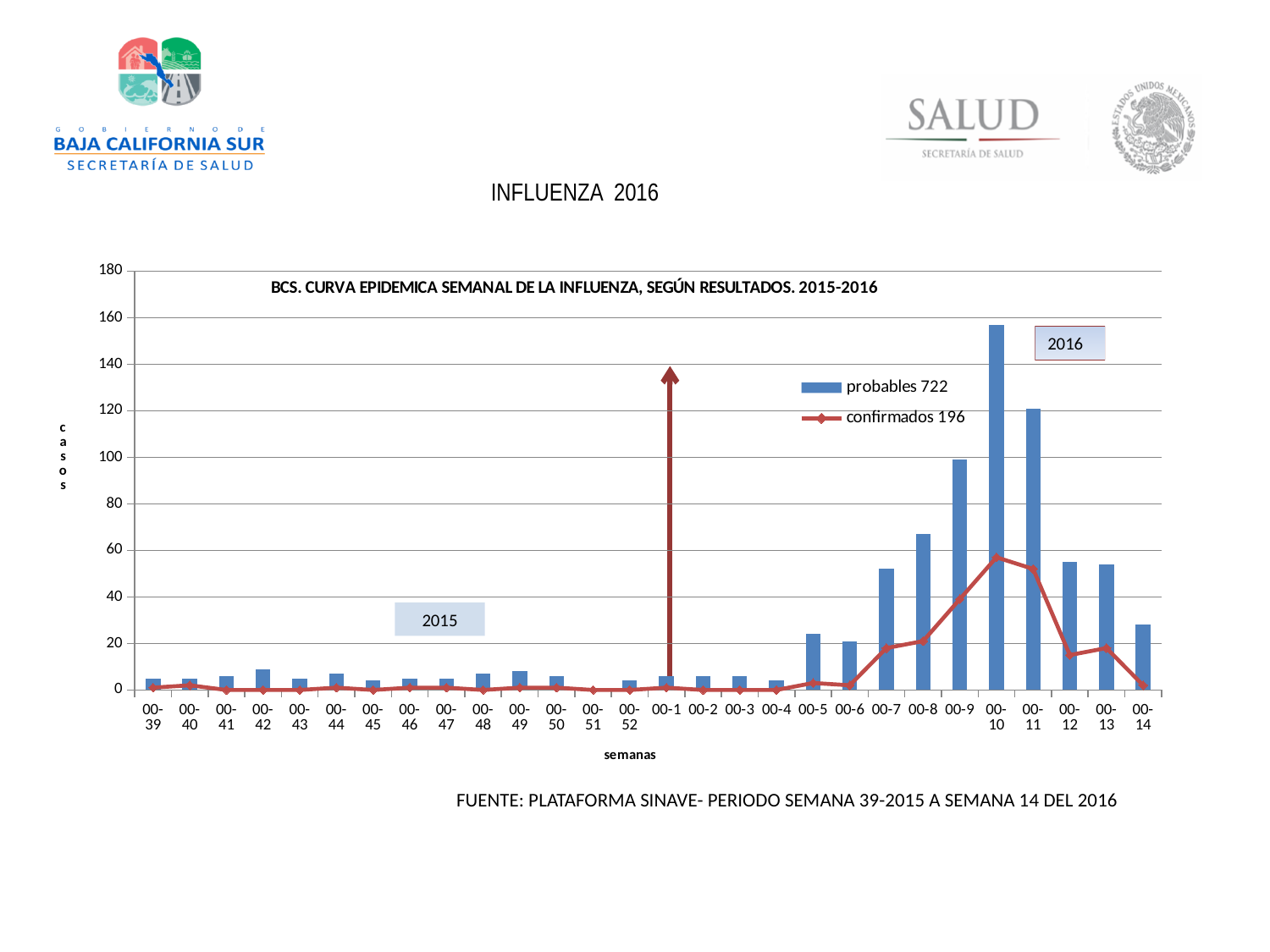
What kind of chart is shown on the slide? A bar chart with a line series overlaid Is the probables value for week 00-10 greater or less than 140? greater How many weeks (categories) are plotted along the x axis? 28 What are the two entries in the chart legend? probables 722 and confirmados 196 Is the probables value for week 00-7 greater or less than 60? less Is the probables value for week 00-11 greater or less than 100? greater How many series does the chart legend list? 2 Which week has more probables, 00-9 or 00-8? 00-9 Do the probables values rise or fall from week 00-5 to week 00-10? rise What is the label on the x axis of the chart? semanas Which week has the highest number of probables (tallest bar)? 00-10